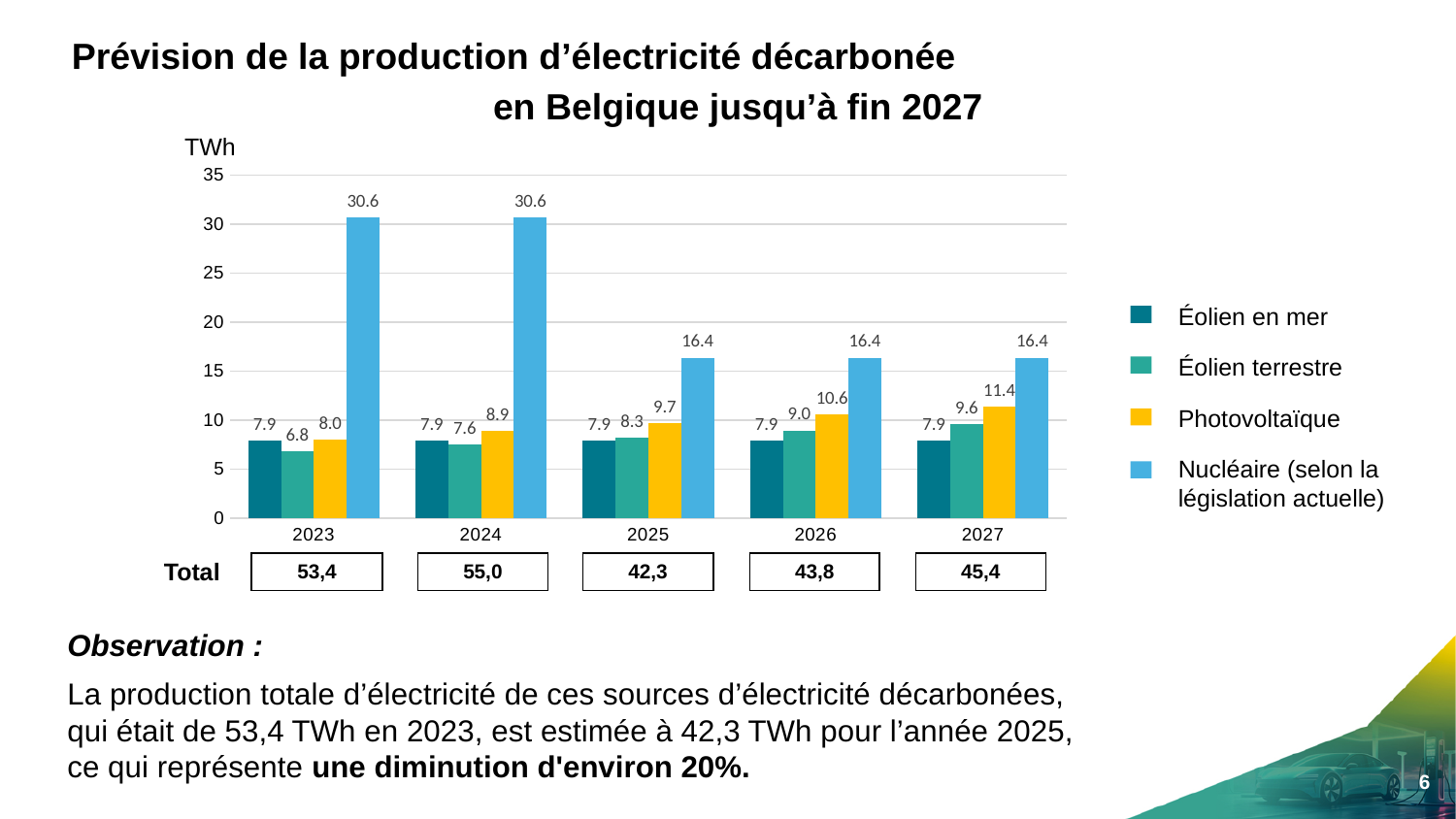
What is the total shown for 2025? 42,3 What is the value for Nucléaire (selon la législation actuelle) in 2023? 30.6 How many series does the legend list? 4 What is the value for Éolien terrestre in 2025? 8.3 What is the value for Photovoltaïque in 2027? 11.4 Does the Photovoltaïque value rise or fall from 2023 to 2027? Rises How many years are shown on the x axis? 5 Which series has the highest value in 2024? Nucléaire (selon la législation actuelle) In 2026, which is larger: Photovoltaïque or Éolien terrestre? Photovoltaïque What kind of chart is shown on the slide? Bar chart Which series has the lowest value in 2023? Éolien terrestre What is the difference between the Nucléaire value in 2024 and in 2025? 14.2